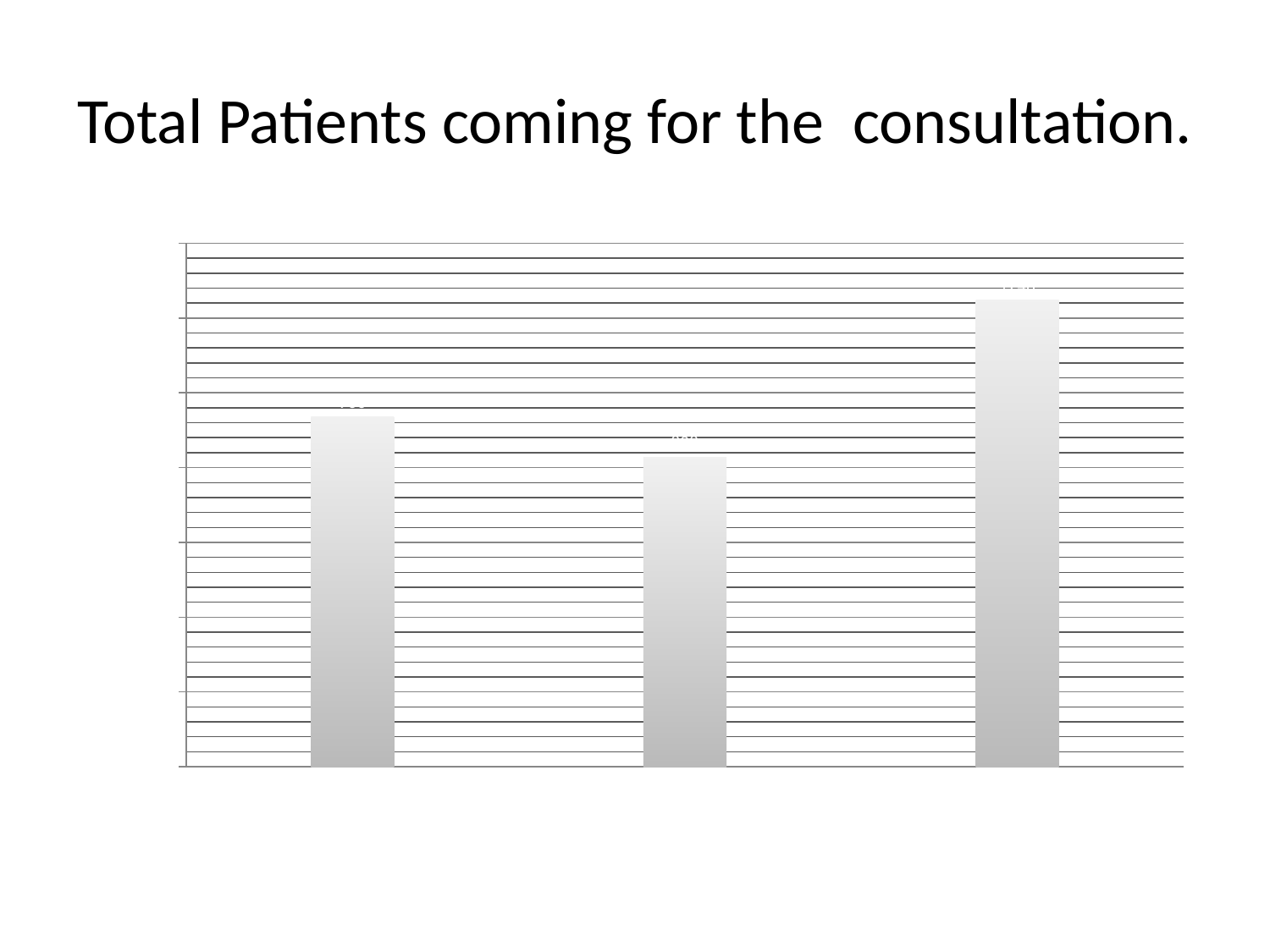
Do the bar heights rise steadily from left to right across the chart? No What is the title of the slide containing the chart? Total Patients coming for the consultation. Is the left bar taller or shorter than the middle bar? taller Is the right bar taller or shorter than the left bar? taller Which bar is the tallest: the left, middle, or right bar? right Which bar is the shortest: the left, middle, or right bar? middle What kind of chart is shown on the slide? bar chart How many bars are plotted in the chart? 3